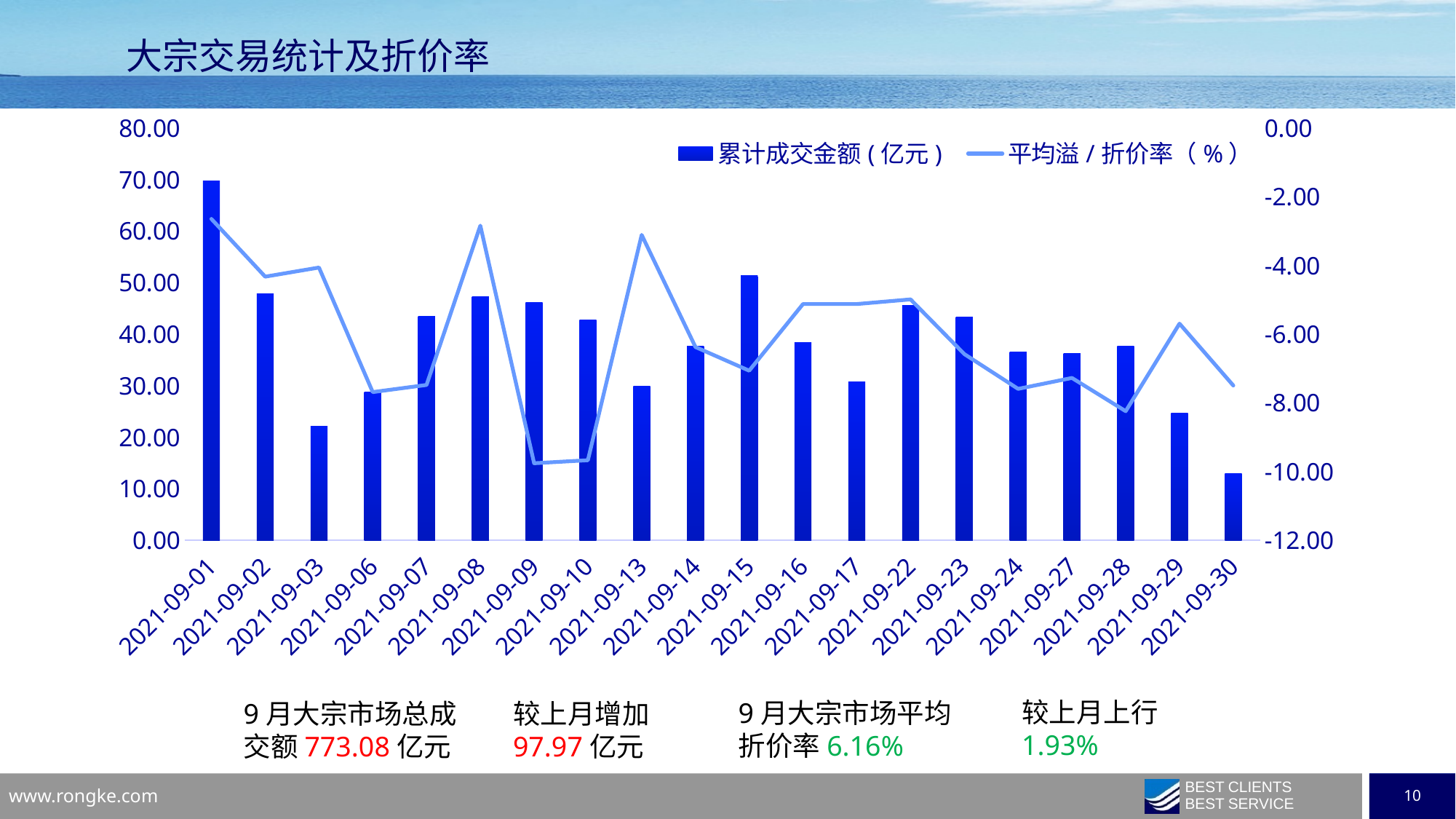
Which series is drawn as a line in the chart? 平均溢/折价率（%） Is the 平均溢/折价率 value for 2021-09-09 greater or less than -8.00? less Is the 累计成交金额 value for 2021-09-30 greater or less than 20.00? less What is the title of the chart on the slide? 大宗交易统计及折价率 On which date is the 累计成交金额 bar the lowest? 2021-09-30 Is the 累计成交金额 value for 2021-09-01 greater or less than 60.00? greater What kind of chart is shown on the slide? A combined bar and line chart On which date is the 累计成交金额 bar the highest? 2021-09-01 Which date has the larger 累计成交金额 bar, 2021-09-01 or 2021-09-02? 2021-09-01 How many series does the chart legend list? 2 How many dates are shown on the x axis of the chart? 20